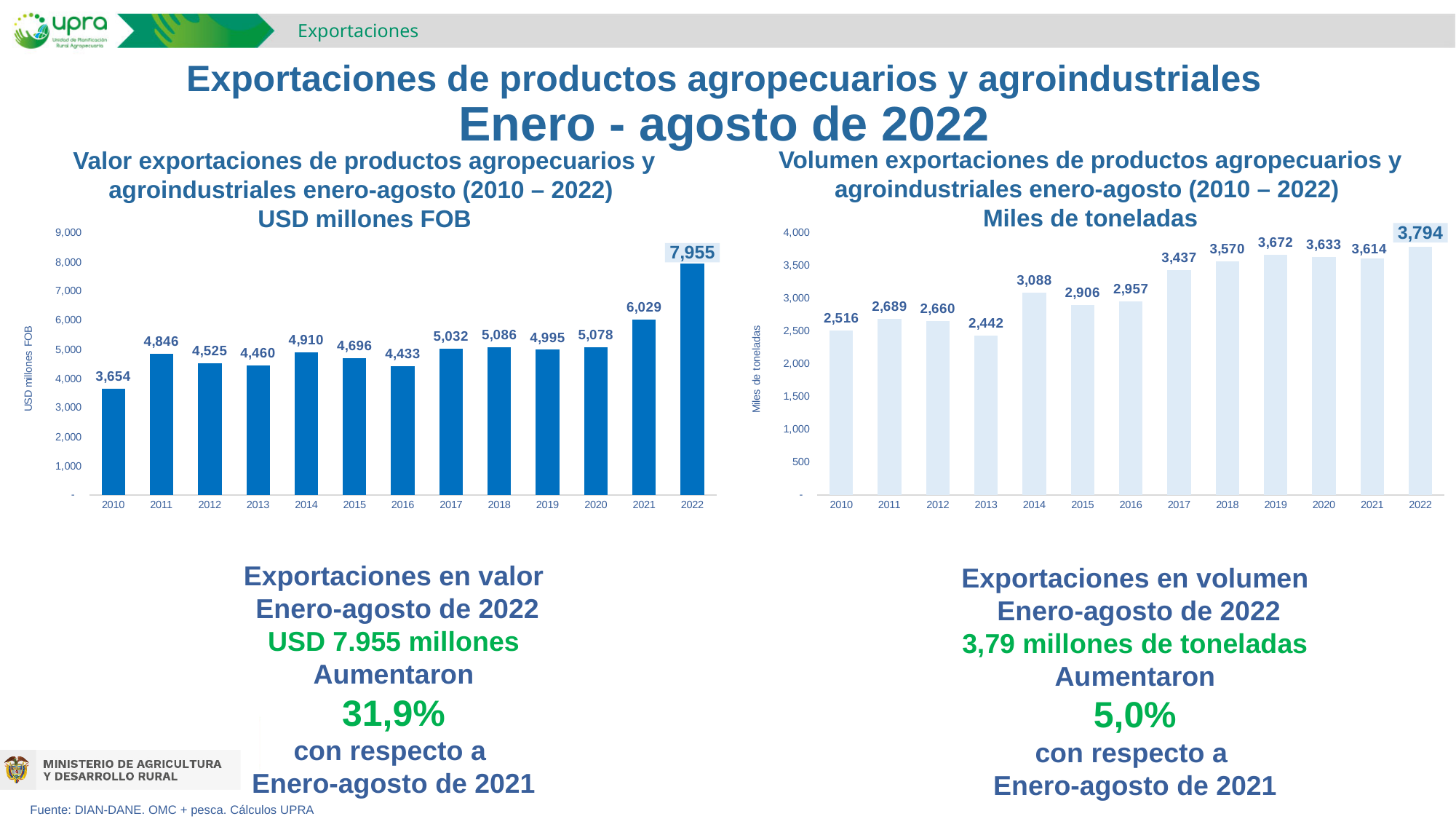
In the right chart (Volumen exportaciones, Miles de toneladas), what is the difference between the 2022 and 2010 values? 1,278 In the left chart (Valor exportaciones, USD millones FOB), which year has the lowest value? 2010 In the right chart (Volumen exportaciones, Miles de toneladas), which year has the lowest value? 2013 In the right chart (Volumen exportaciones, Miles de toneladas), what is the value for 2014? 3,088 In the left chart (Valor exportaciones, USD millones FOB), what is the value for 2016? 4,433 In the right chart (Volumen exportaciones, Miles de toneladas), which year has the highest value? 2022 In the left chart (Valor exportaciones, USD millones FOB), what is the value for 2022? 7,955 In the left chart (Valor exportaciones, USD millones FOB), what is the difference between the 2022 and 2021 values? 1,926 In the left chart (Valor exportaciones, USD millones FOB), how many years are plotted? 13 In the right chart (Volumen exportaciones, Miles de toneladas), which is larger, the value for 2019 or the value for 2021? 2019 What kind of chart is the right chart (Volumen exportaciones, Miles de toneladas)? Bar chart What is the y-axis label of the left chart (Valor exportaciones)? USD millones FOB